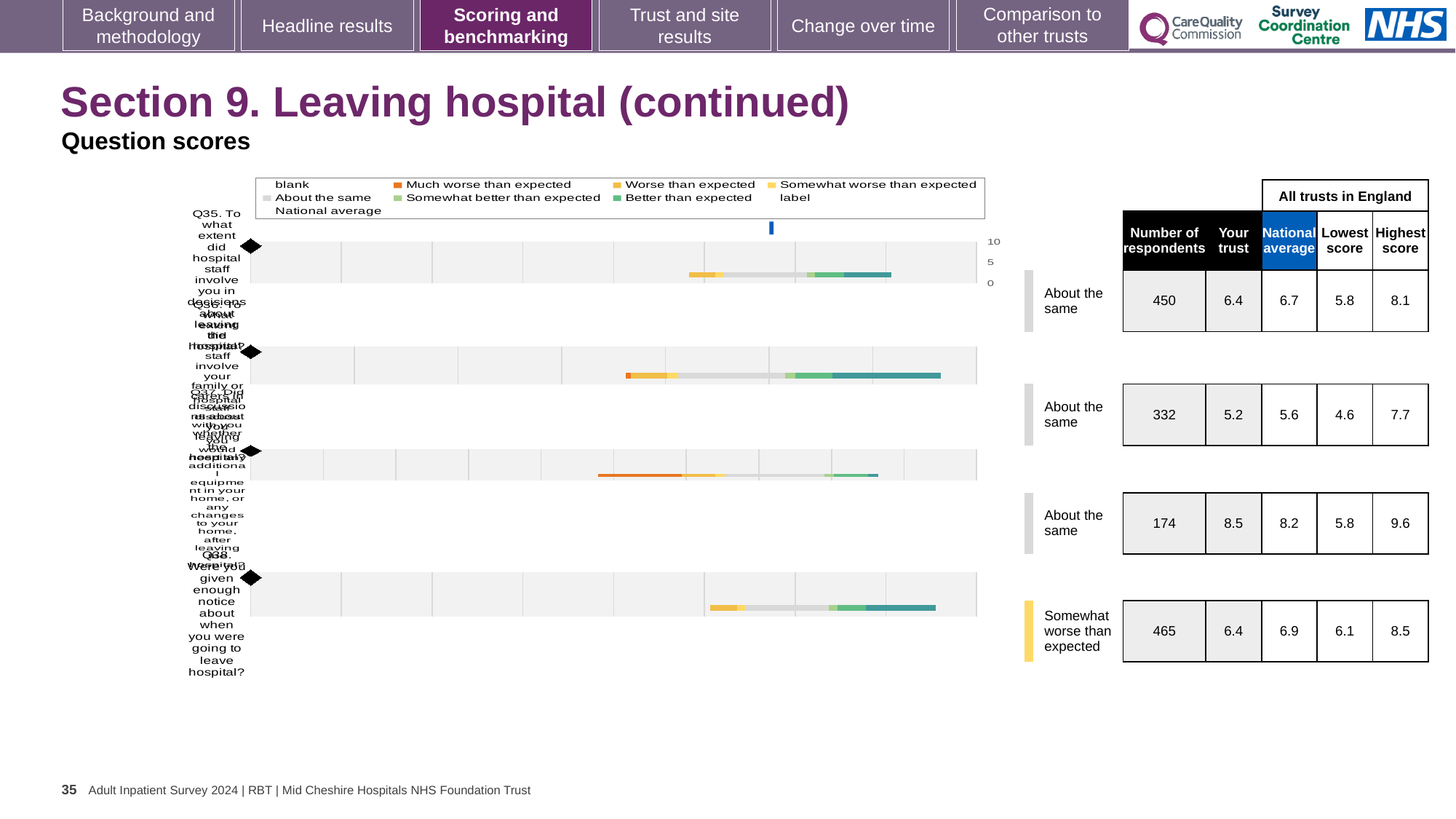
Which question has the highest 'Your trust' score? Q37 What kind of chart is used to show the question scores on this slide? bar chart How many questions (bars) are plotted in the question scores chart? 4 Which question has the lowest 'Your trust' score? Q36 What is the 'Your trust' score for Q37 (additional equipment or changes to your home)? 8.5 What is the lowest score among all trusts in England for Q36? 4.6 For Q38, how much higher is the national average than the 'Your trust' score? 0.5 What is the highest score among all trusts in England for Q37? 9.6 What is the national average score for Q38 (enough notice about leaving hospital)? 6.9 According to the table next to the chart, how many respondents answered Q35? 450 Which benchmark category is shown for Q38? Somewhat worse than expected For Q35, which is larger: the 'Your trust' score or the national average? National average